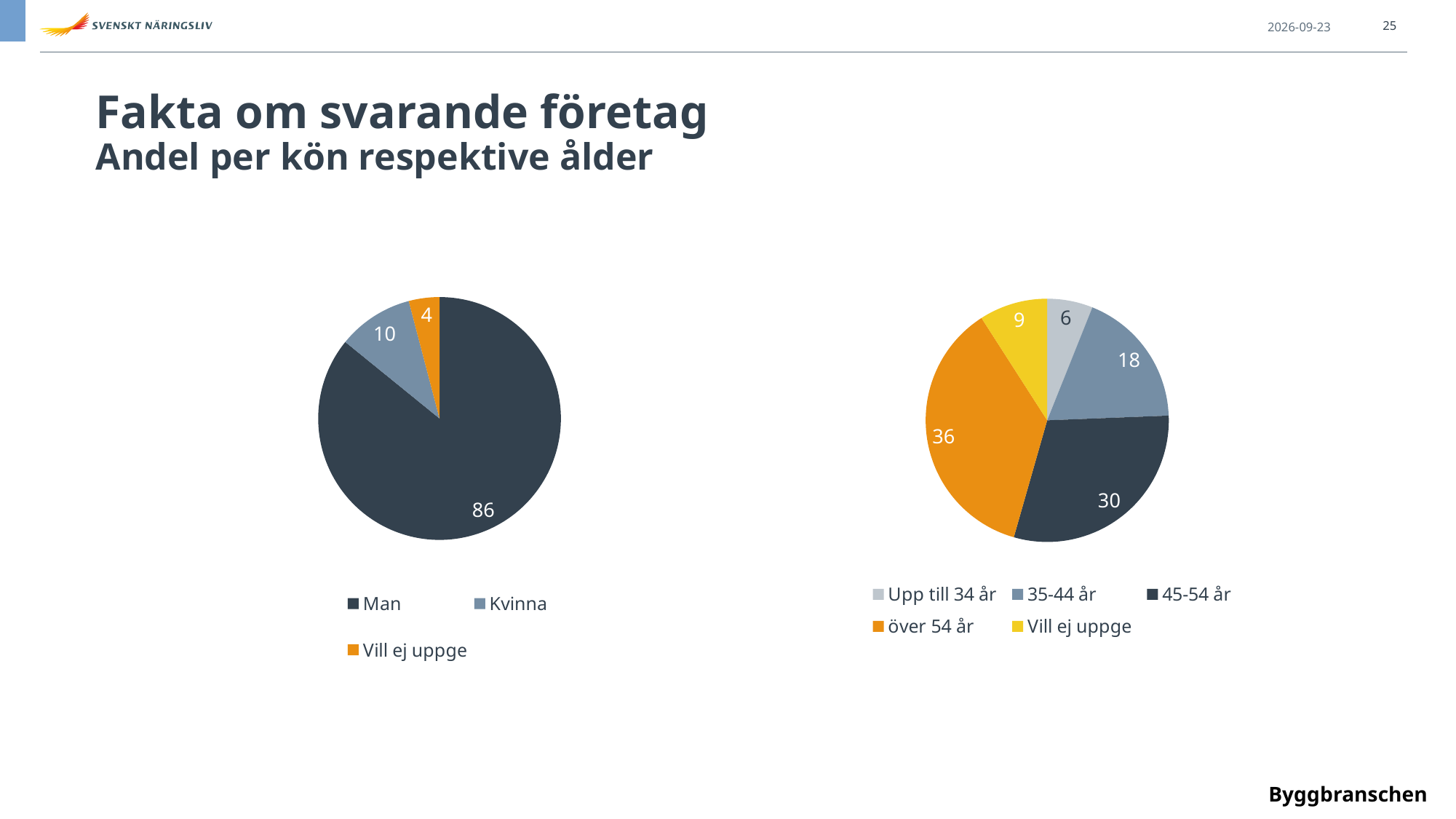
In the left pie chart, what is the difference between the values for Man and Kvinna? 76 In the right pie chart, which category has the largest slice? över 54 år In the left pie chart, what is the value for Kvinna? 10 How many categories does the legend of the right pie chart list? 5 What kind of chart is the left chart? Pie chart In the right pie chart, which is larger, 35-44 år or Vill ej uppge? 35-44 år In the left pie chart, which category has the smallest slice? Vill ej uppge In the right pie chart, what is the value for Upp till 34 år? 6 In the right pie chart, what is the value for 45-54 år? 30 In the left pie chart, what is the value for Vill ej uppge? 4 In the right pie chart, what is the difference between the values for över 54 år and 45-54 år? 6 In the left pie chart, what is the value for Man? 86